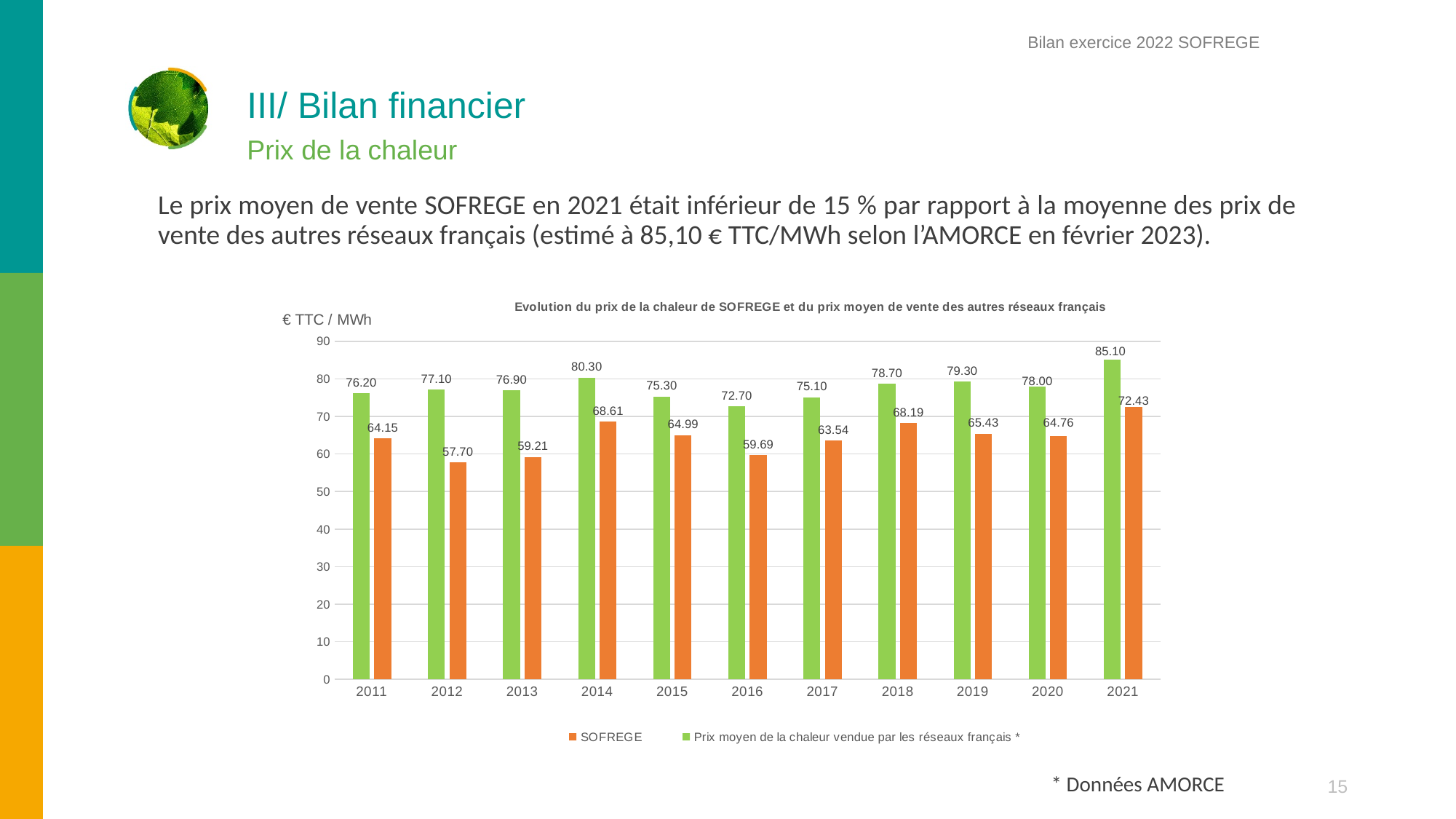
What unit is shown on the y axis of the chart? € TTC / MWh Which is larger: the SOFREGE value for 2018 or the SOFREGE value for 2019? 2018 What is the SOFREGE value for 2014? 68.61 What is the value of 'Prix moyen de la chaleur vendue par les réseaux français' for 2016? 72.70 How many series does the legend list? 2 Is the SOFREGE value for 2013 greater or less than 60? less What is the SOFREGE value for 2021? 72.43 How many years are shown on the x axis? 11 In which year is the SOFREGE value the lowest? 2012 What kind of chart is shown on the slide? bar chart In which year is the 'Prix moyen de la chaleur vendue par les réseaux français' value the highest? 2021 What is the difference between the 'Prix moyen de la chaleur vendue par les réseaux français' value and the SOFREGE value in 2021? 12.67